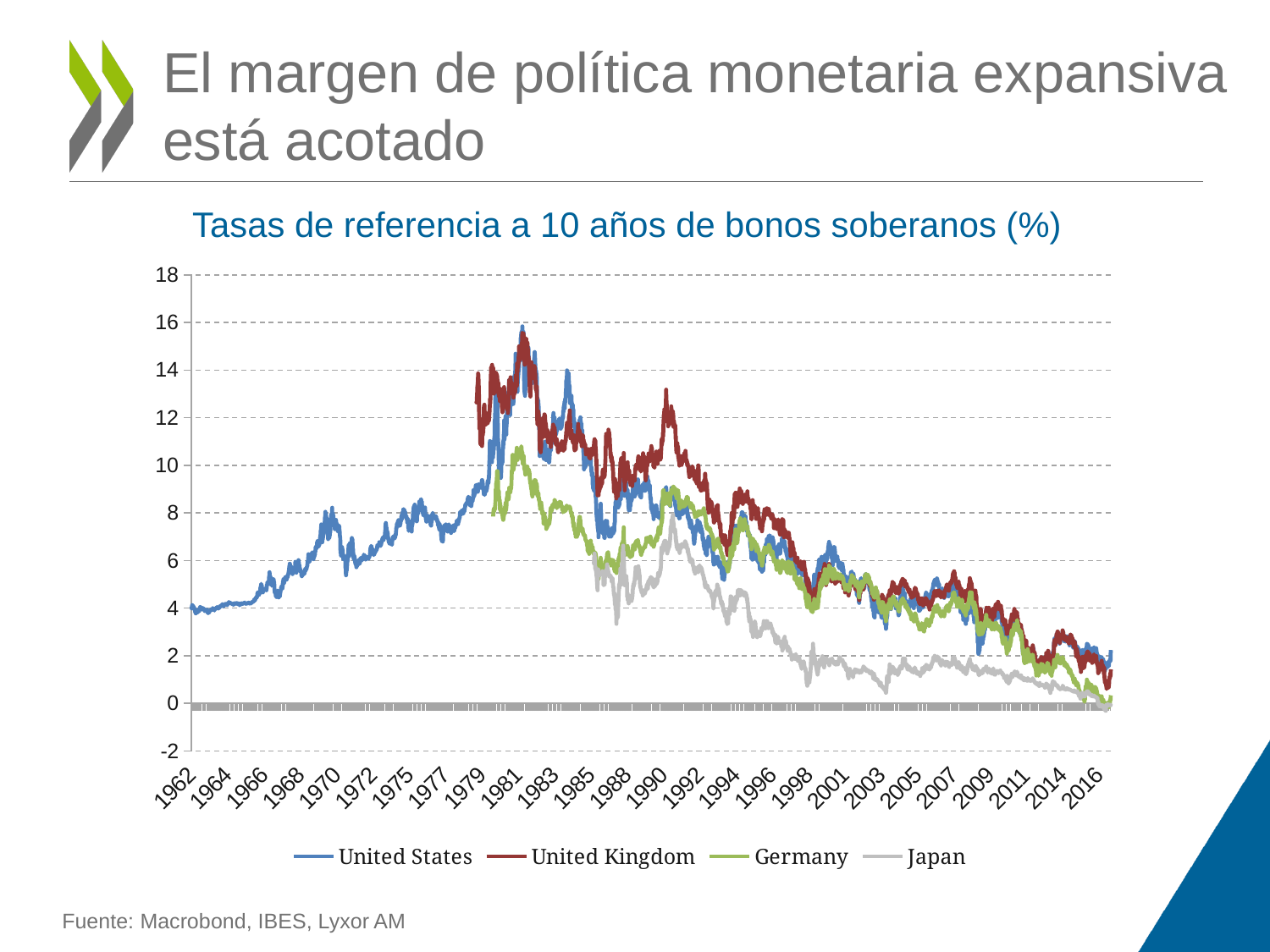
Which is larger around 1998, the value for United Kingdom or the value for Japan? United Kingdom Is the value for Japan in 2016 greater or less than 2? less Which colour is used for the Japan line? grey How many series does the legend list? 4 Is the peak value for United States around 1981 greater or less than 14? greater Is the value for United Kingdom around 1990 greater or less than 10? greater Which series has the lowest value around 2005? Japan What is the title of the chart? Tasas de referencia a 10 años de bonos soberanos (%) What kind of chart is shown on the slide? line chart Which series has data starting earliest, in 1962? United States Do the values for United States rise or fall from 1981 to 2016? fall